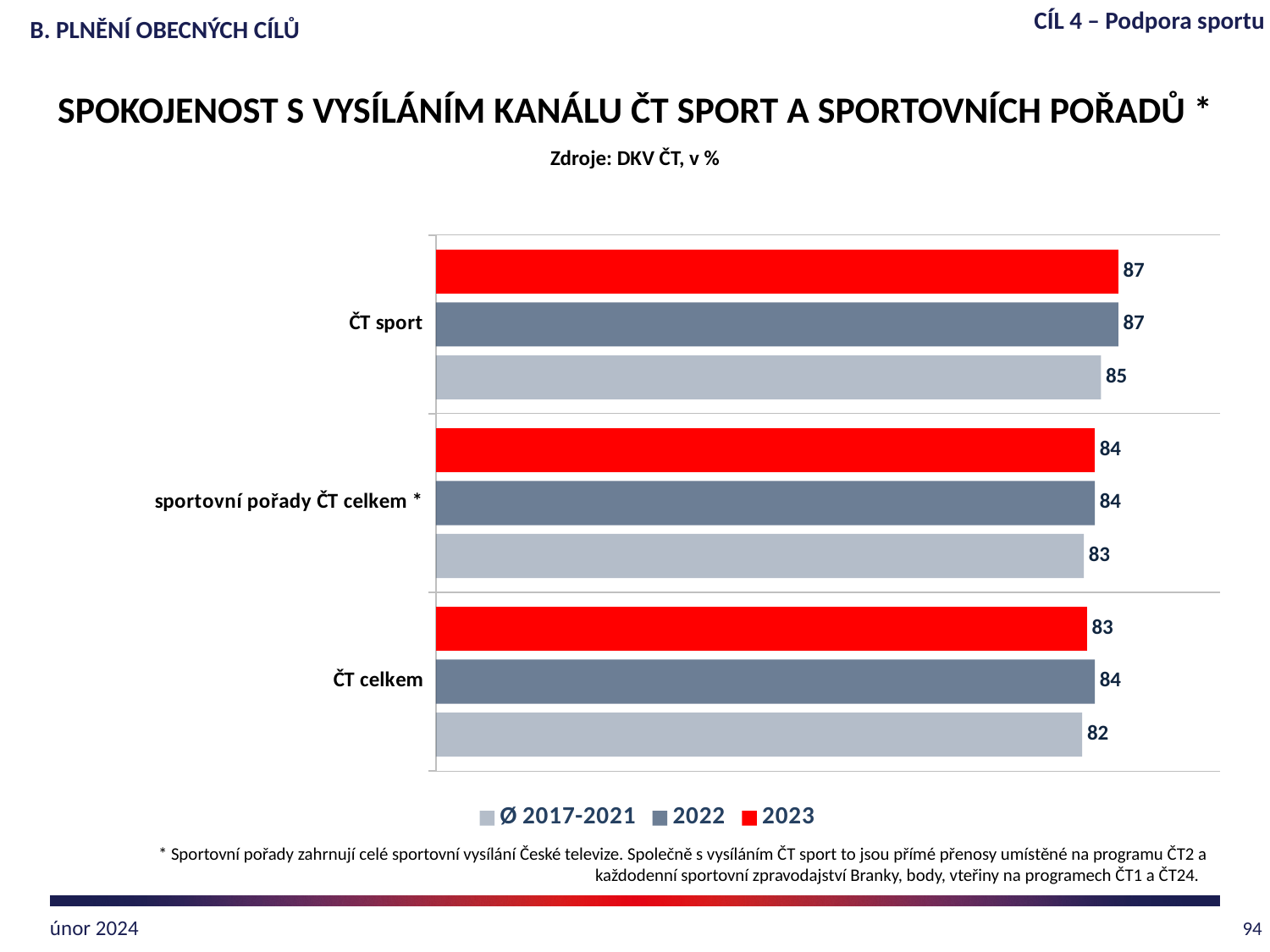
What is the 2023 value for ČT celkem? 83 Which category has the highest Ø 2017-2021 value? ČT sport How many series does the legend list? 3 How many categories are shown on the chart? 3 What is the 2023 value for ČT sport? 87 Which series is shown in red in the legend? 2023 For ČT celkem, which is larger: the 2022 value or the 2023 value? 2022 What is the Ø 2017-2021 value for ČT celkem? 82 Which category has the lowest 2023 value? ČT celkem What is the difference between the 2023 value for ČT sport and the 2023 value for ČT celkem? 4 What kind of chart is shown on the slide? bar chart What is the 2022 value for sportovní pořady ČT celkem? 84